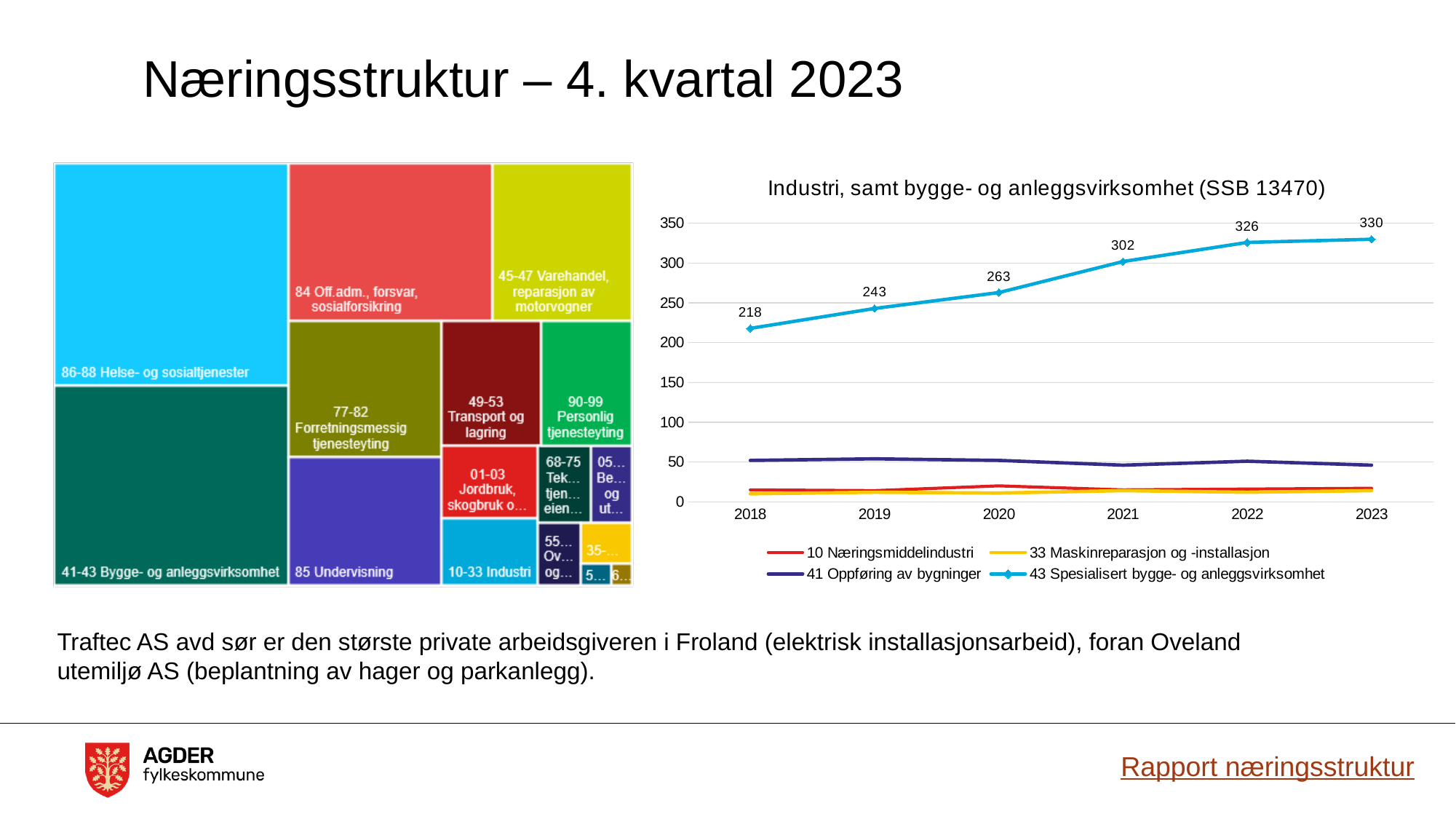
What kind of chart is the chart titled "Industri, samt bygge- og anleggsvirksomhet (SSB 13470)"? line chart In the chart titled "Industri, samt bygge- og anleggsvirksomhet (SSB 13470)", is the value for 41 Oppføring av bygninger in 2023 greater or less than 100? less In the chart titled "Industri, samt bygge- og anleggsvirksomhet (SSB 13470)", what is the value for 43 Spesialisert bygge- og anleggsvirksomhet in 2023? 330 In the chart titled "Industri, samt bygge- og anleggsvirksomhet (SSB 13470)", what is the value for 43 Spesialisert bygge- og anleggsvirksomhet in 2018? 218 In the chart titled "Industri, samt bygge- og anleggsvirksomhet (SSB 13470)", in which year is 43 Spesialisert bygge- og anleggsvirksomhet highest? 2023 In the chart titled "Industri, samt bygge- og anleggsvirksomhet (SSB 13470)", what is the value for 43 Spesialisert bygge- og anleggsvirksomhet in 2021? 302 In the chart titled "Industri, samt bygge- og anleggsvirksomhet (SSB 13470)", in which year is 43 Spesialisert bygge- og anleggsvirksomhet lowest? 2018 In the chart titled "Industri, samt bygge- og anleggsvirksomhet (SSB 13470)", how many series does the legend list? 4 In the chart titled "Industri, samt bygge- og anleggsvirksomhet (SSB 13470)", does 43 Spesialisert bygge- og anleggsvirksomhet rise or fall from 2018 to 2023? rise In the chart titled "Industri, samt bygge- og anleggsvirksomhet (SSB 13470)", by how much did 43 Spesialisert bygge- og anleggsvirksomhet increase from 2018 to 2023? 112 In the chart titled "Industri, samt bygge- og anleggsvirksomhet (SSB 13470)", which series is larger in 2020: 41 Oppføring av bygninger or 10 Næringsmiddelindustri? 41 Oppføring av bygninger In the chart titled "Industri, samt bygge- og anleggsvirksomhet (SSB 13470)", how many years are shown on the x axis? 6